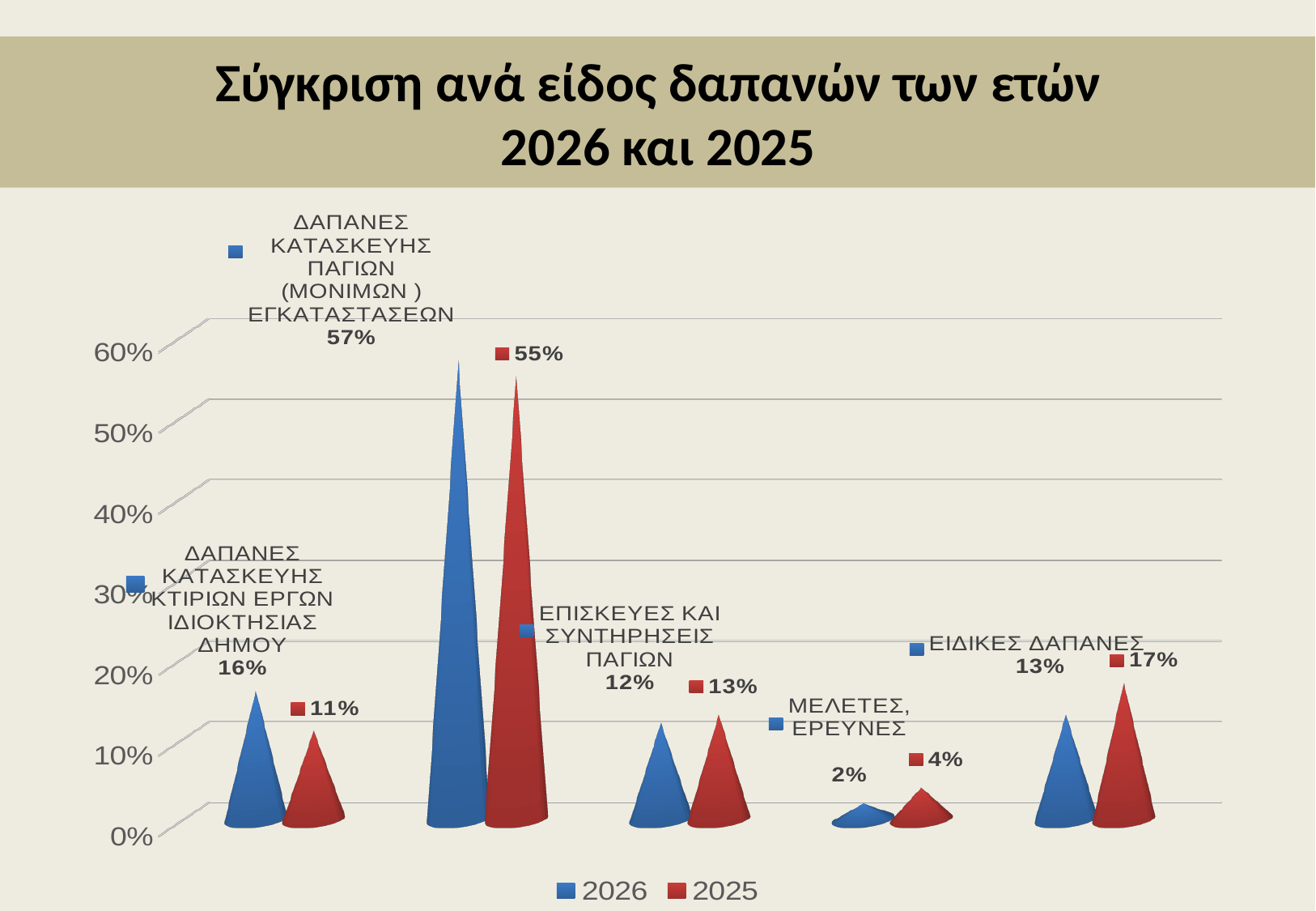
How many series does the legend list? 2 What kind of chart is shown on the slide? bar chart What is the 2026 value for ΜΕΛΕΤΕΣ, ΕΡΕΥΝΕΣ? 2% What is the 2025 value for ΕΙΔΙΚΕΣ ΔΑΠΑΝΕΣ? 17% What is the difference between the 2026 and 2025 values for ΔΑΠΑΝΕΣ ΚΑΤΑΣΚΕΥΗΣ ΚΤΙΡΙΩΝ ΕΡΓΩΝ ΙΔΙΟΚΤΗΣΙΑΣ ΔΗΜΟΥ? 5% Which category has the lowest 2025 value? ΜΕΛΕΤΕΣ, ΕΡΕΥΝΕΣ What is the 2025 value for ΔΑΠΑΝΕΣ ΚΑΤΑΣΚΕΥΗΣ ΚΤΙΡΙΩΝ ΕΡΓΩΝ ΙΔΙΟΚΤΗΣΙΑΣ ΔΗΜΟΥ? 11% For ΕΙΔΙΚΕΣ ΔΑΠΑΝΕΣ, which year has the larger value, 2026 or 2025? 2025 How many expense categories are shown on the chart? 5 Is the 2025 value for ΔΑΠΑΝΕΣ ΚΑΤΑΣΚΕΥΗΣ ΠΑΓΙΩΝ (ΜΟΝΙΜΩΝ) ΕΓΚΑΤΑΣΤΑΣΕΩΝ greater or less than 50%? greater Which category has the highest 2026 value? ΔΑΠΑΝΕΣ ΚΑΤΑΣΚΕΥΗΣ ΠΑΓΙΩΝ (ΜΟΝΙΜΩΝ) ΕΓΚΑΤΑΣΤΑΣΕΩΝ What is the 2026 value for ΔΑΠΑΝΕΣ ΚΑΤΑΣΚΕΥΗΣ ΠΑΓΙΩΝ (ΜΟΝΙΜΩΝ) ΕΓΚΑΤΑΣΤΑΣΕΩΝ? 57%